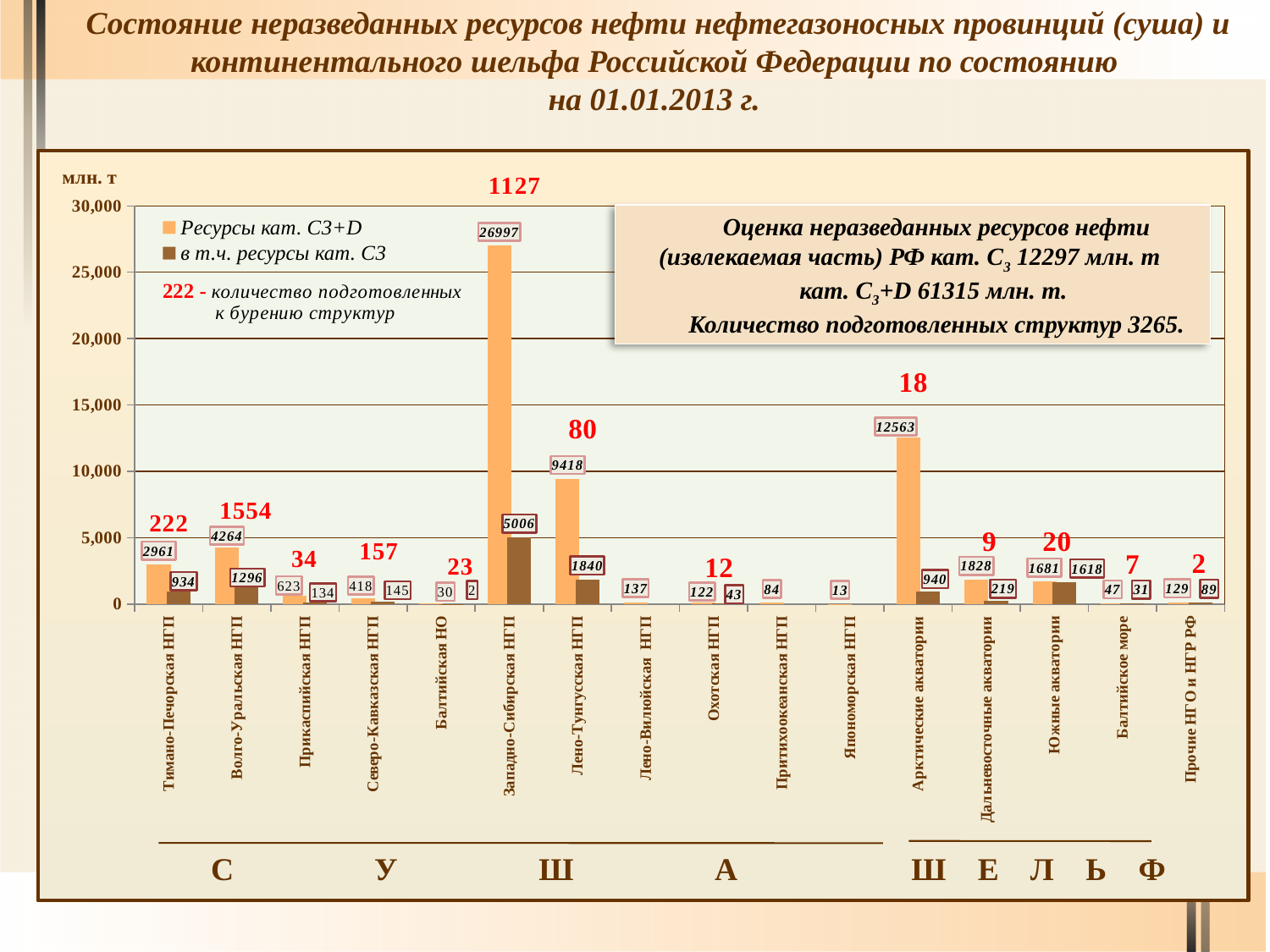
How many categories are shown on the x axis of the chart? 16 What is the value of в т.ч. ресурсы кат. С3 for Арктические акватории? 940 What kind of chart is shown on the slide? bar chart What is the value of Ресурсы кат. С3+D for Западно-Сибирская НГП? 26997 What is the value of в т.ч. ресурсы кат. С3 for Южные акватории? 1618 What is the red number (количество подготовленных к бурению структур) shown above Волго-Уральская НГП? 1554 What is the difference between Ресурсы кат. С3+D and в т.ч. ресурсы кат. С3 for Лено-Тунгусская НГП? 7578 Is the value of Ресурсы кат. С3+D for Волго-Уральская НГП greater or less than 5,000? less What unit is shown on the y axis of the chart? млн. т How many series does the legend list? 2 Which category has the highest value of Ресурсы кат. С3+D? Западно-Сибирская НГП Which has the larger value of Ресурсы кат. С3+D: Арктические акватории or Лено-Тунгусская НГП? Арктические акватории